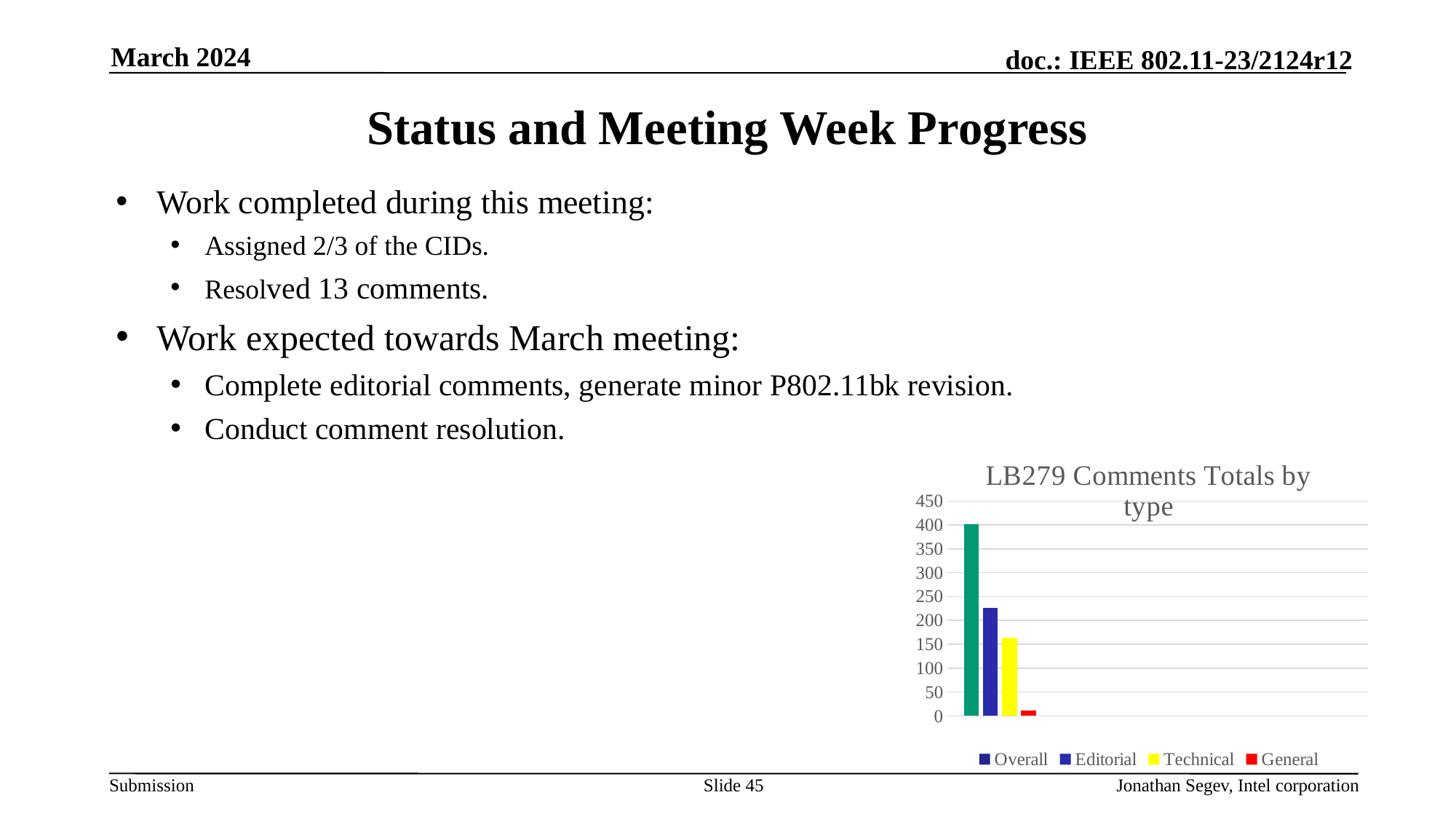
Is the value for Overall greater or less than 350? greater How many series does the chart legend list? 4 Which is larger, the value for Editorial or the value for Technical? Editorial Is the value for Editorial greater or less than 200? greater Is the value for Editorial greater or less than 250? less Which series has the lowest value in the chart? General What colour is used for the General series in the chart? red What is the title of the chart? LB279 Comments Totals by type Which series has the highest value in the chart? Overall What type of chart is shown on the slide? bar chart